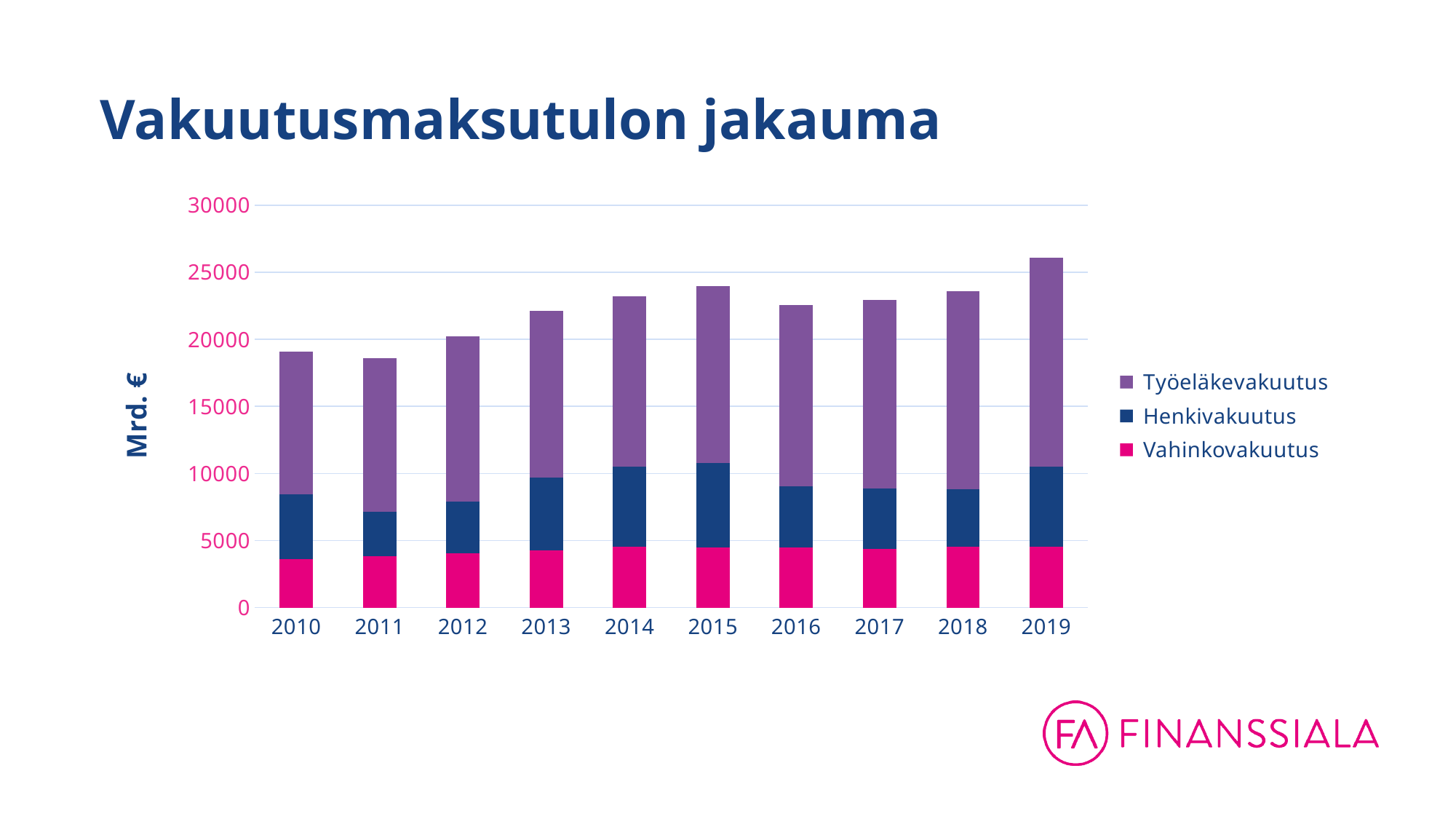
Which series is shown in pink in the chart? Vahinkovakuutus Do the total bars generally rise or fall from 2010 to 2019? Rise Which year has the larger total bar, 2015 or 2016? 2015 How many series does the chart legend list? 3 What kind of chart is shown on the slide? Stacked bar chart Is the total bar for 2010 greater or less than 20000? less Is the total bar for 2015 greater or less than 25000? less Is the Vahinkovakuutus value for 2010 greater or less than 5000? less How many years are shown on the x axis of the chart? 10 Which year has the highest total bar in the chart? 2019 What is the label on the y axis of the chart? Mrd. €